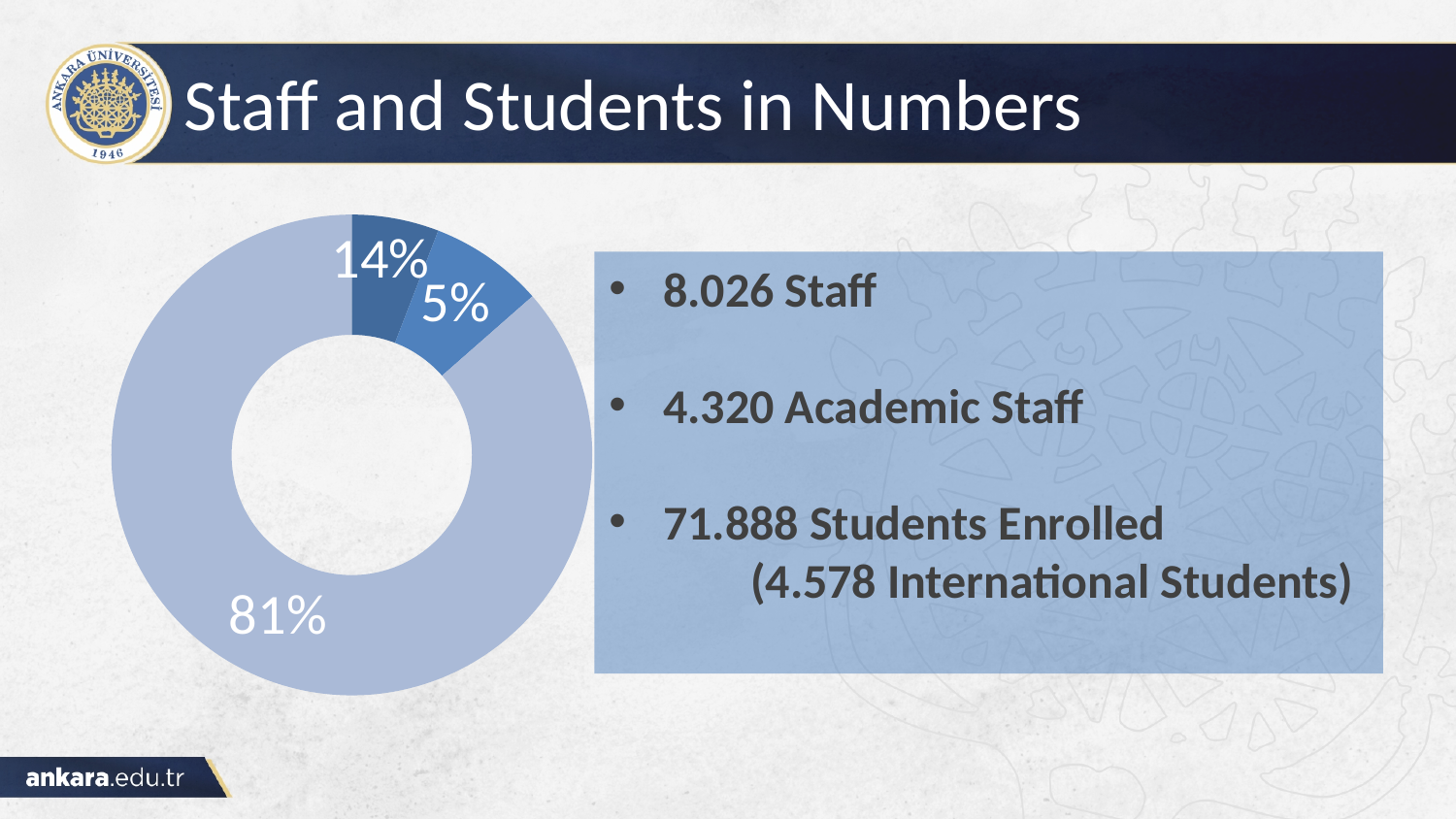
What is the title of the slide containing the doughnut chart? Staff and Students in Numbers What is the difference in percentage points between the 14% slice and the 5% slice? 9 What is the percentage shown on the largest slice of the doughnut chart? 81% What percentage is shown on the medium blue slice of the doughnut chart? 5% What percentage is shown on the light blue slice of the doughnut chart? 81% How many slices does the doughnut chart have? 3 What percentage is shown on the dark blue slice of the doughnut chart? 14% What kind of chart is shown on the slide? Doughnut chart Is the largest slice of the doughnut chart greater or less than 50%? greater